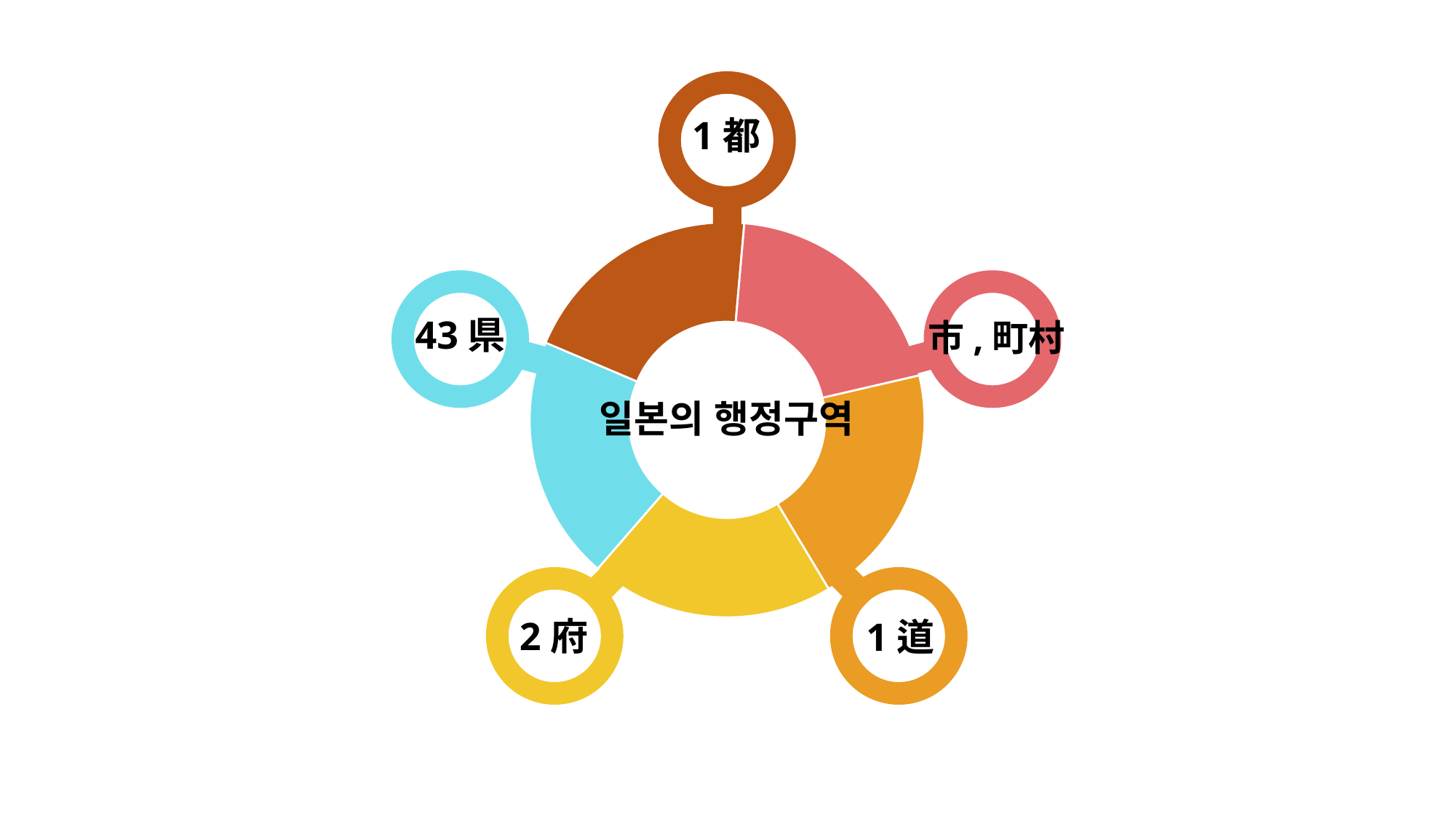
What number is shown with 府 in the diagram? 2 Which label is attached to the light-blue (cyan) segment of the ring? 43 県 What number is shown with 県 in the diagram? 43 How many segments does the ring diagram on the slide have? 5 What text is written in the centre of the ring diagram? 일본의 행정구역 What number is shown with 道 in the diagram? 1 What number is shown with 都 in the diagram? 1